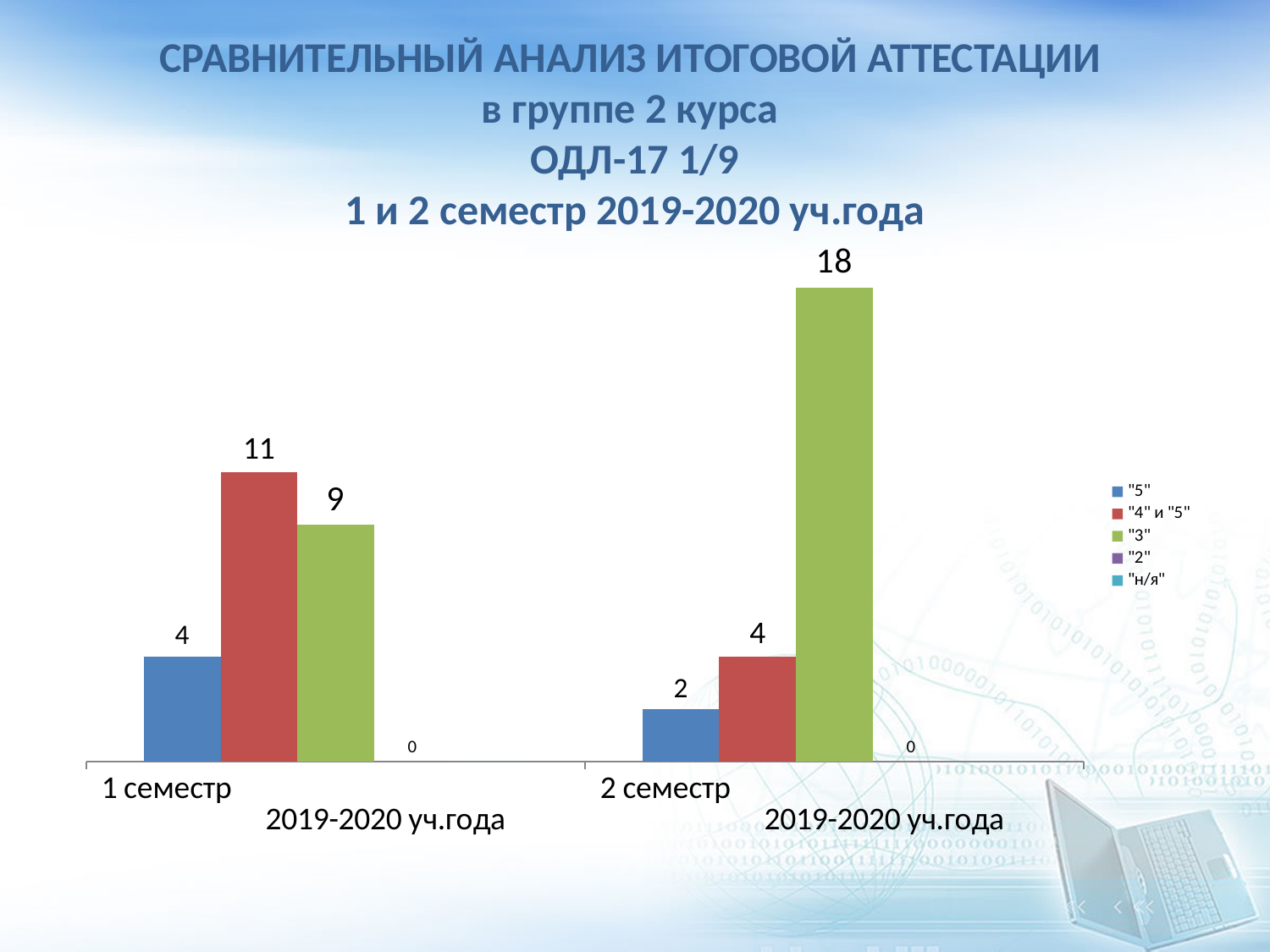
What is the value for "4" и "5" in 1 семестр 2019-2020 уч.года? 11 How many series does the legend list? 5 What kind of chart is shown on the slide? Bar chart What is the value for "3" in 1 семестр 2019-2020 уч.года? 9 What is the value for "5" in 2 семестр 2019-2020 уч.года? 2 What is the value for "3" in 2 семестр 2019-2020 уч.года? 18 How many categories (semesters) are shown on the x axis? 2 Which semester has the larger value for "4" и "5": 1 семестр or 2 семестр? 1 семестр What is the difference between the "3" values for 2 семестр and 1 семестр? 9 Which series has the highest value in 2 семестр 2019-2020 уч.года? "3" What is the value for "5" in 1 семестр 2019-2020 уч.года? 4 Which series has the highest value in 1 семестр 2019-2020 уч.года? "4" и "5"